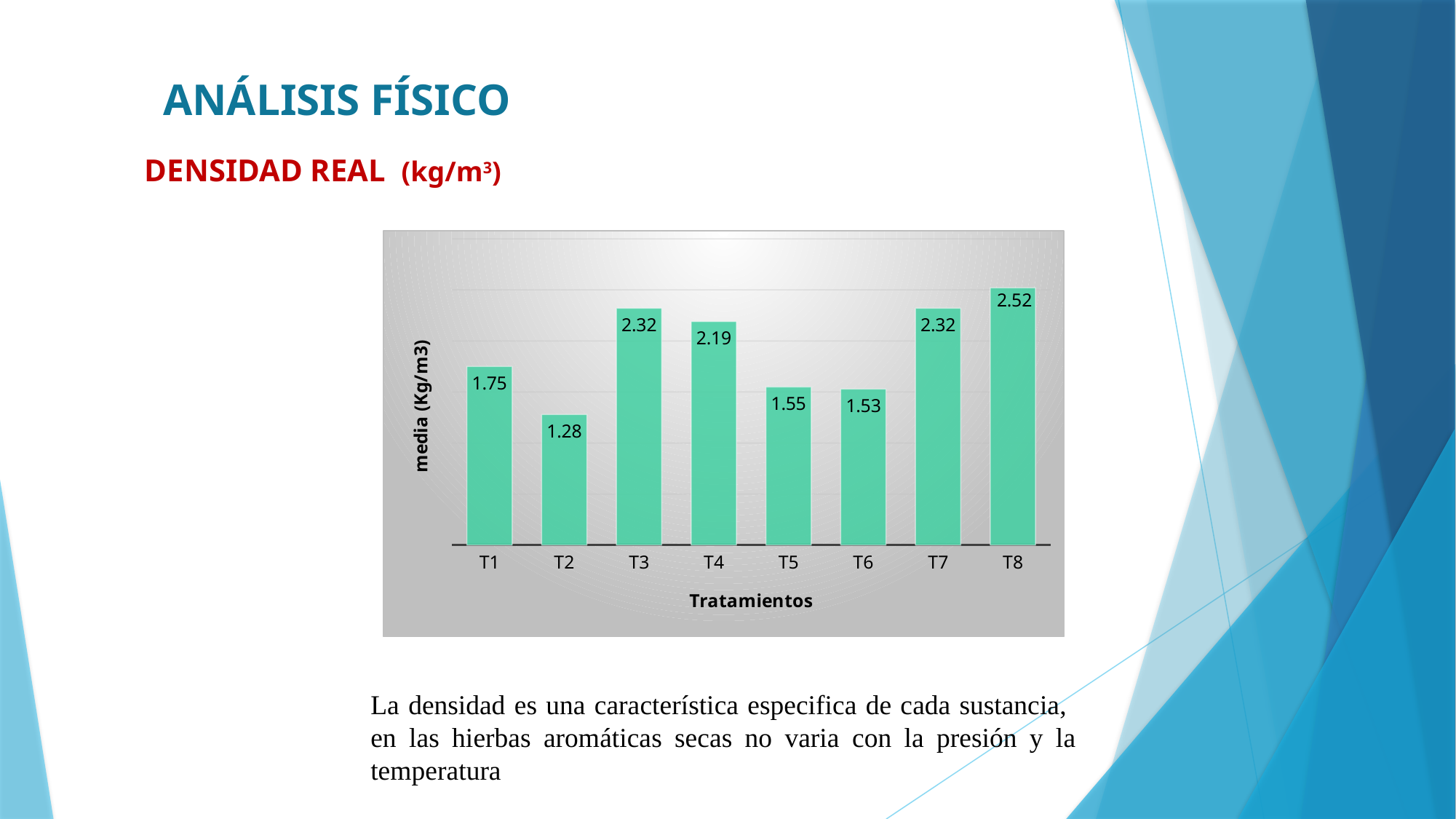
What is the value for T6? 1.53 What is the difference between the values for T3 and T4? 0.13 What is the difference between the values for T8 and T2? 1.24 What is the label of the x axis? Tratamientos What is the value for T1? 1.75 Which is larger, the value for T1 or the value for T5? T1 How many treatments are shown on the x axis? 8 What is the value for T4? 2.19 Which treatment has the lowest value? T2 What is the label of the y axis? media (Kg/m3) What kind of chart is shown on the slide? Bar chart Which treatment has the highest value? T8